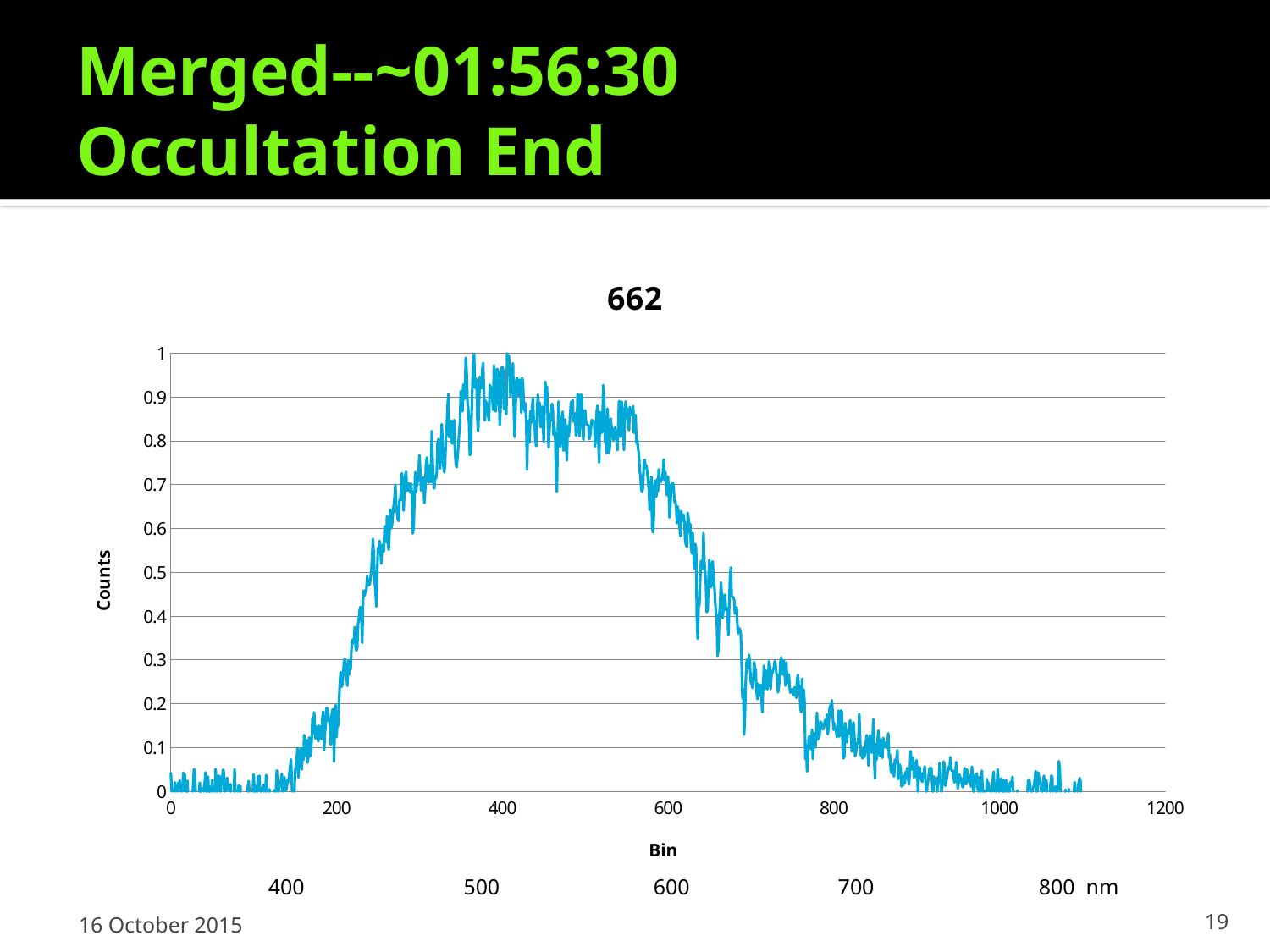
What is the title of the chart? 662 Is the value for bin 800 greater or less than 0.5? less Is the value at bin 400 larger or smaller than the value at bin 800? larger What is the label of the y axis of the chart? Counts Is the value for bin 1000 greater or less than 0.3? less What is the highest tick value shown on the x axis (Bin)? 1200 Do the values rise or fall along the x axis between bin 200 and bin 400? rise Is the value for bin 400 greater or less than 0.5? greater Do the values rise or fall along the x axis between bin 600 and bin 1000? fall What kind of chart is shown on the slide? line chart